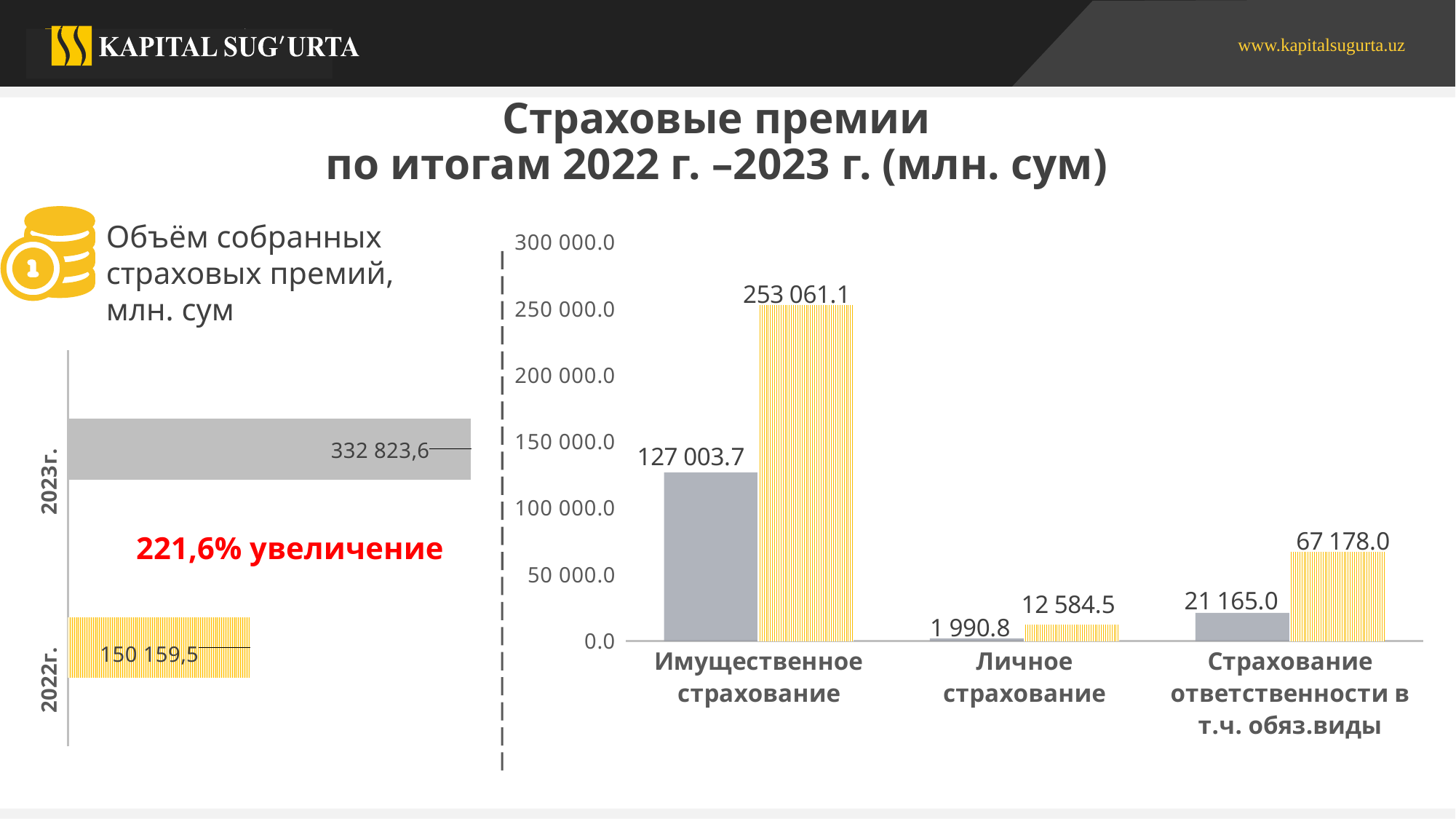
In the right chart, is the yellow striped bar for Имущественное страхование greater or less than 200 000.0? greater In the right chart, what is the value of the gray bar for Имущественное страхование? 127 003.7 In the right chart, what is the value of the yellow striped bar for Имущественное страхование? 253 061.1 In the right chart, what is the value of the gray bar for Страхование ответственности в т.ч. обяз.виды? 21 165.0 In the left chart, what is the value shown for 2023г.? 332 823,6 In the left chart, what is the value shown for 2022г.? 150 159,5 In the right chart, what is the difference between the yellow striped bar and the gray bar for Страхование ответственности в т.ч. обяз.виды? 46 013.0 In the right chart, which category has the highest yellow striped bar? Имущественное страхование How many categories are shown on the x axis of the right chart? 3 What kind of chart is the left chart on the slide? bar chart In the left chart, what percentage increase is printed between 2022 and 2023? 221,6% увеличение In the right chart, what is the value of the yellow striped bar for Личное страхование? 12 584.5